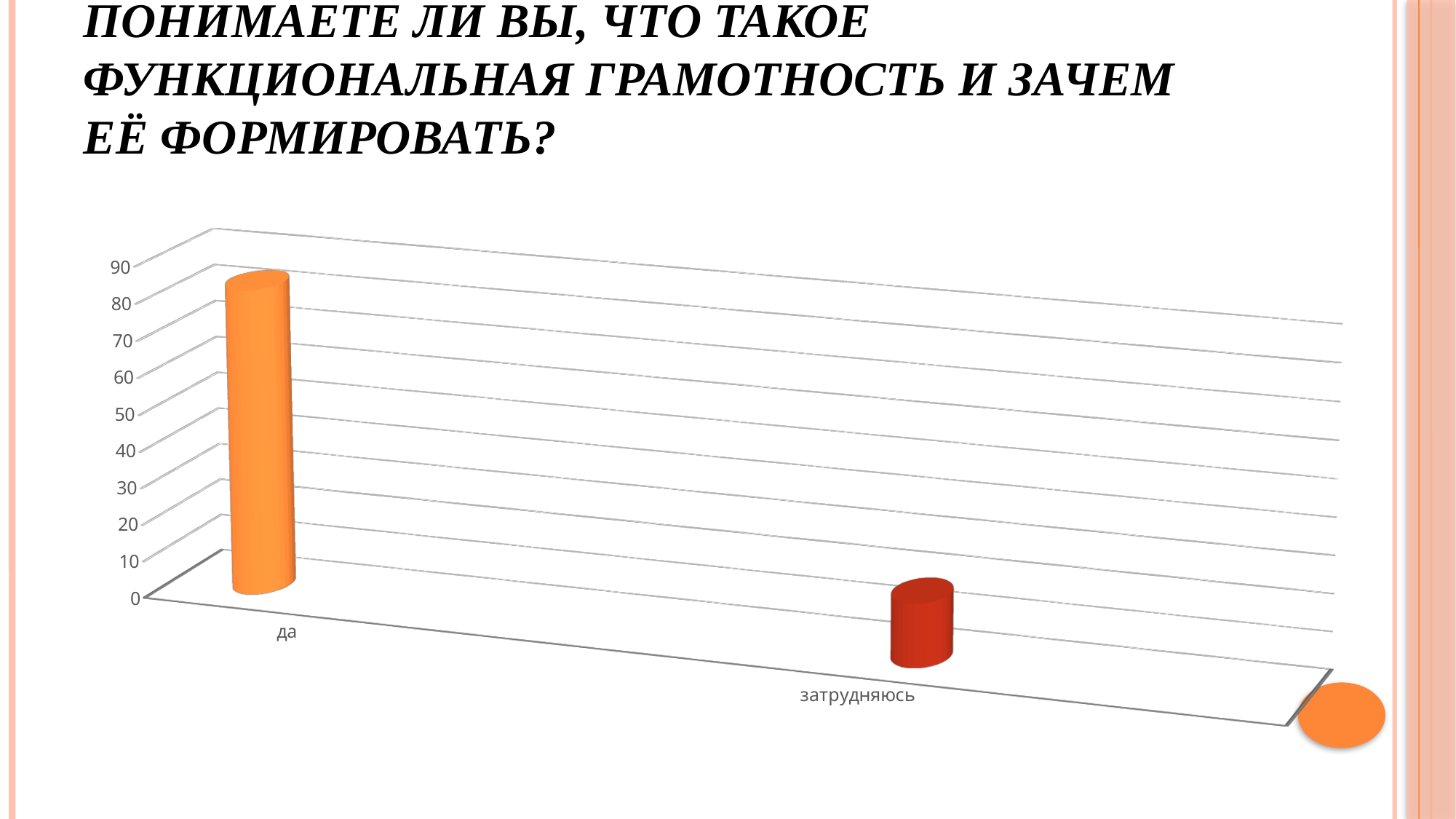
Is the value for да greater or less than 50? greater What is the highest value shown on the vertical axis of the chart? 90 What colour is the bar for да? orange Is the value for затрудняюсь greater or less than 40? less Which category has the highest bar? да How many category labels are shown on the x axis of the chart? 2 What kind of chart is shown on the slide? bar chart Is the value for затрудняюсь greater or less than 50? less Which of the two labelled categories, да or затрудняюсь, has the lower bar? затрудняюсь Which is larger, the value for да or the value for затрудняюсь? да